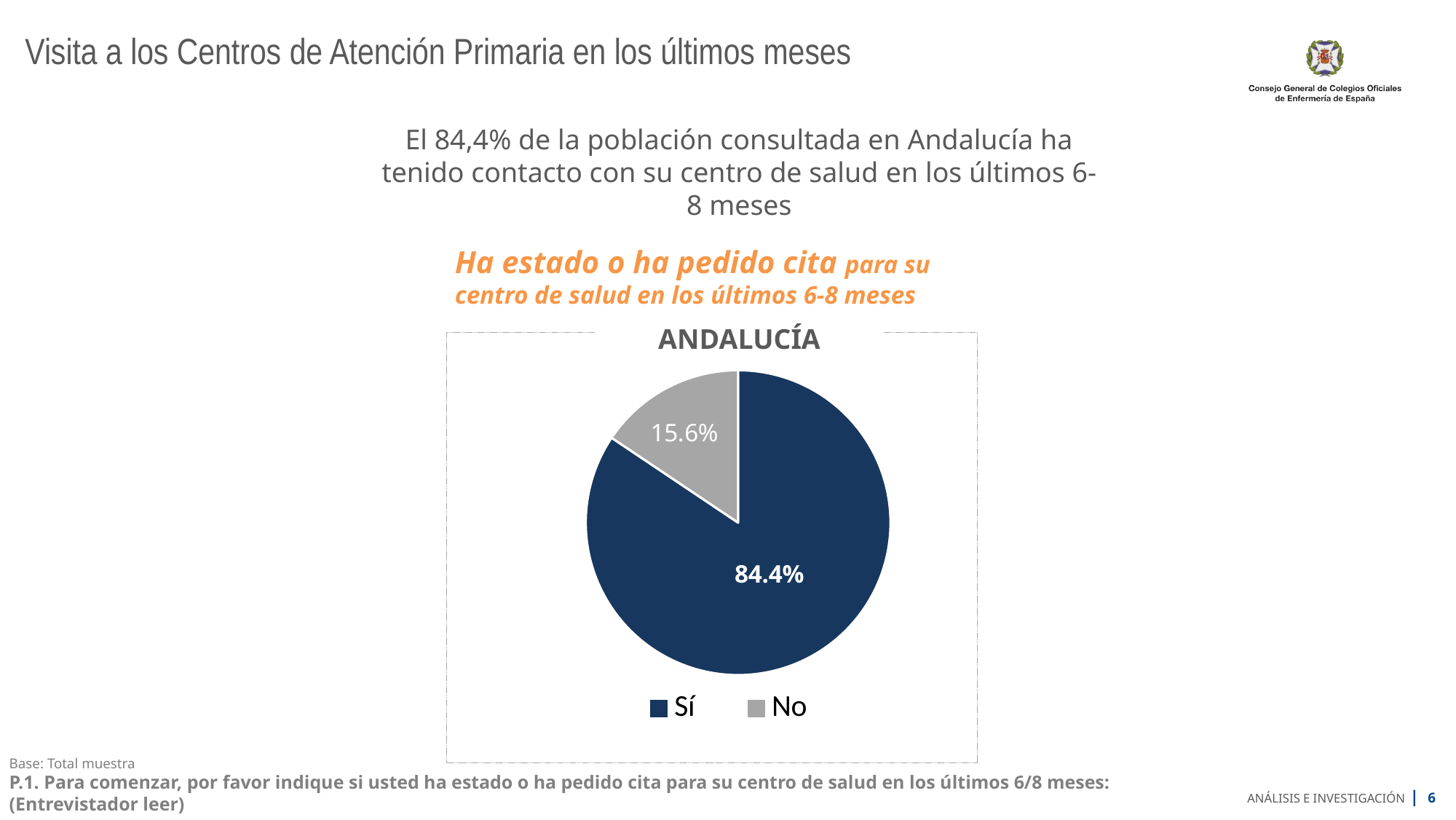
What is the difference in percentage points between the "Sí" and "No" slices? 68.8 How many slices does the pie chart have? 2 Which slice is the largest in the pie chart? Sí What percentage of the pie is labelled "No"? 15.6% What percentage of the pie is labelled "Sí"? 84.4% How many entries does the legend list? 2 What share of the pie does the "Sí" slice represent? 84.4% Which slice is the smallest in the pie chart? No Which is larger, the "Sí" slice or the "No" slice? Sí What is the chart's title? ANDALUCÍA What colour is the "No" slice in the pie chart? Grey What type of chart is shown on the slide? Pie chart